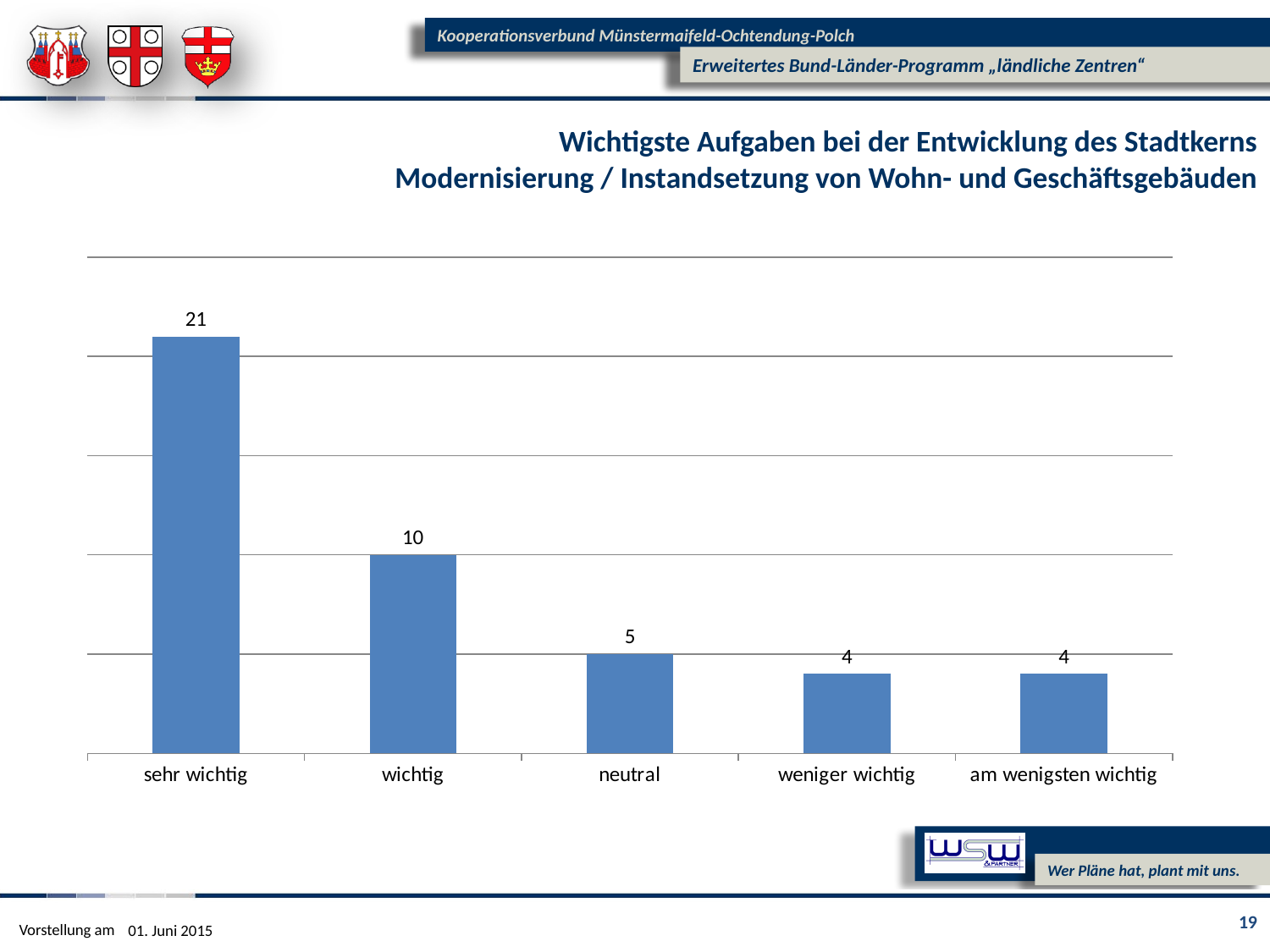
What kind of chart is shown on the slide? bar chart What is the value for "weniger wichtig"? 4 What is the difference between the values for "wichtig" and "neutral"? 5 What is the total of all five bars? 44 What is the value for "wichtig"? 10 Do the values rise or fall from left to right along the x axis? fall Which is larger, the value for "wichtig" or the value for "neutral"? wichtig What is the value for "sehr wichtig"? 21 What is the value for "neutral"? 5 How many categories are shown on the x axis? 5 What is the difference between the values for "sehr wichtig" and "wichtig"? 11 Which category has the highest value? sehr wichtig